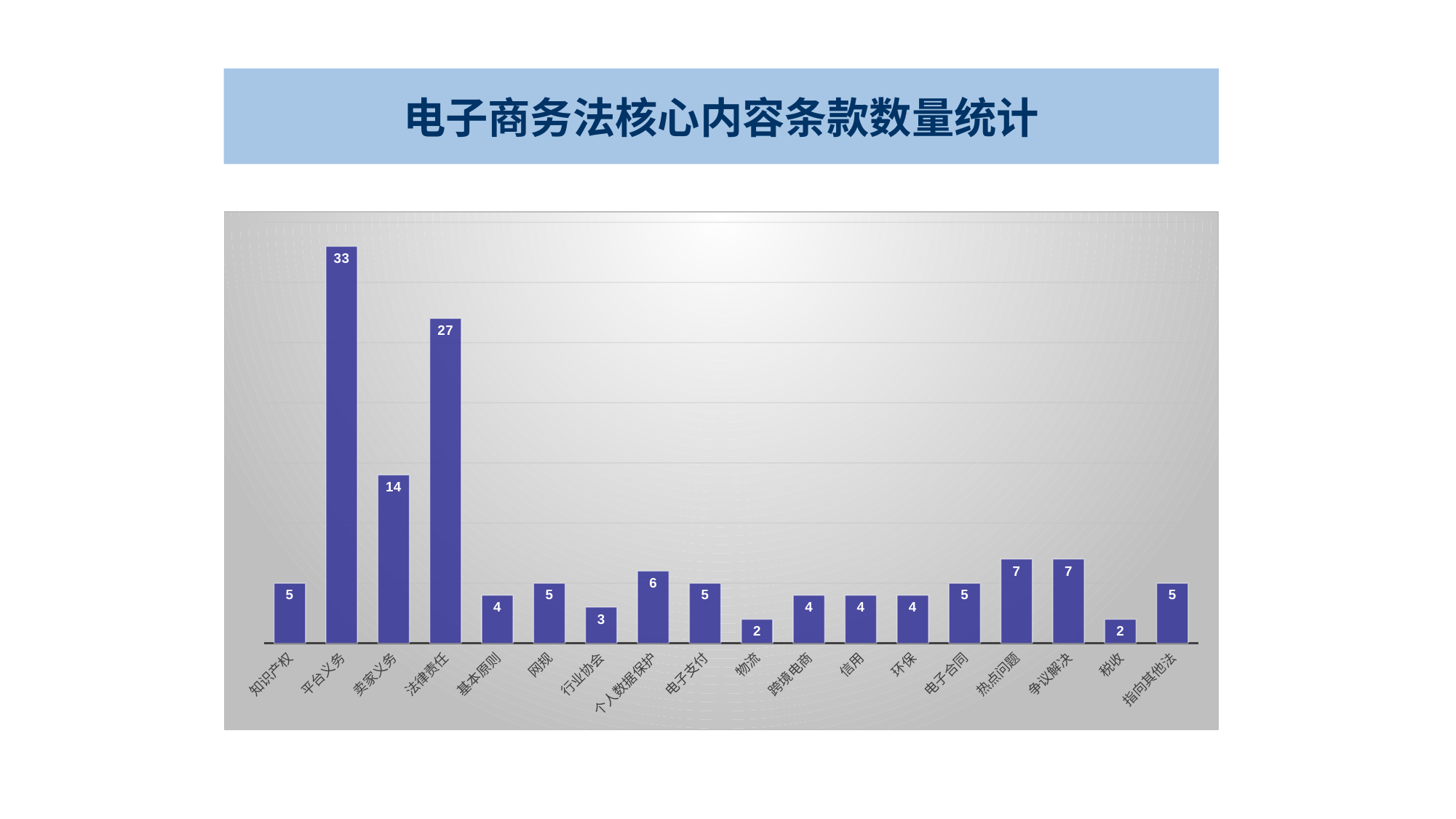
How many categories are shown on the x axis? 18 What is the difference between the values for 平台义务 and 法律责任? 6 What is the value for 平台义务? 33 What is the value for 行业协会? 3 What is the title of the slide? 电子商务法核心内容条款数量统计 What is the value for 个人数据保护? 6 Which is larger, the value for 法律责任 or the value for 卖家义务? 法律责任 What is the difference between the values for 卖家义务 and 热点问题? 7 What kind of chart is shown on the slide? bar chart Which category has the highest value? 平台义务 What is the value for 卖家义务? 14 What is the value for 法律责任? 27